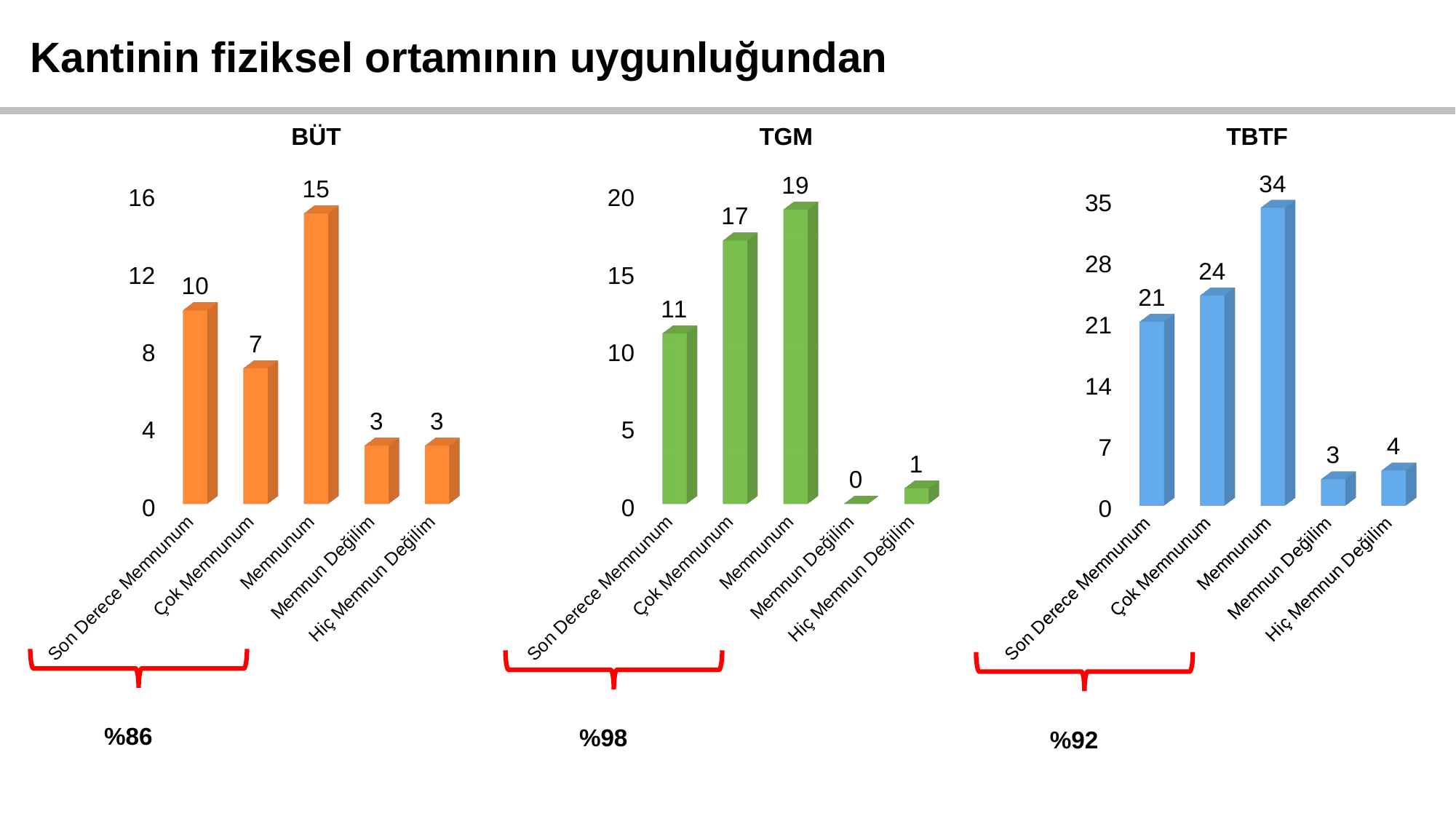
How many categories does the BÜT chart show? 5 In the TGM chart, what is the value for Çok Memnunum? 17 In the TBTF chart, what is the value for Son Derece Memnunum? 21 In the TBTF chart, what is the difference between the values for Hiç Memnun Değilim and Memnun Değilim? 1 In the TBTF chart, which category has the highest value? Memnunum What colour are the bars in the TBTF chart? blue In the BÜT chart, what is the value for Memnunum? 15 In the TGM chart, is the value for Memnunum greater or less than 15? greater In the TGM chart, which category has the lowest value? Memnun Değilim In the TBTF chart, which is larger, the value for Çok Memnunum or the value for Son Derece Memnunum? Çok Memnunum What kind of chart is the TGM chart? bar chart In the BÜT chart, what is the difference between the values for Memnunum and Son Derece Memnunum? 5